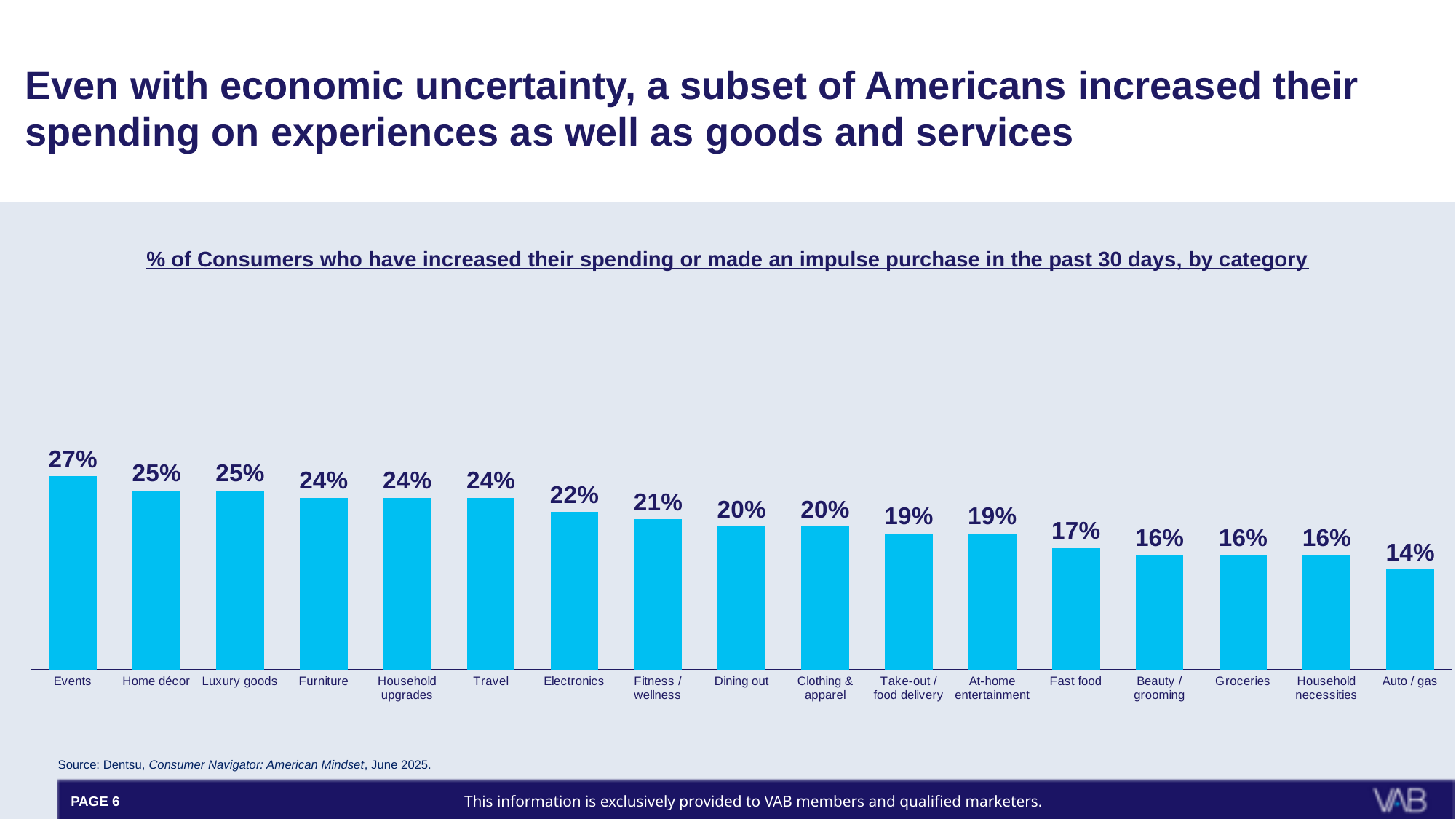
What is the value for Fast food? 17% What is the value for Take-out / food delivery? 19% Which is larger, the value for Furniture or the value for Groceries? Furniture What is the value for Events? 27% What kind of chart is shown on the slide? Bar chart Which category has the highest value? Events What is the difference between the values for Events and Auto / gas? 13% How many categories are shown in the chart? 17 Which category has the lowest value? Auto / gas What is the value for Electronics? 22% What is the difference between the values for Travel and Dining out? 4% Do the values rise or fall from left to right across the categories? Fall